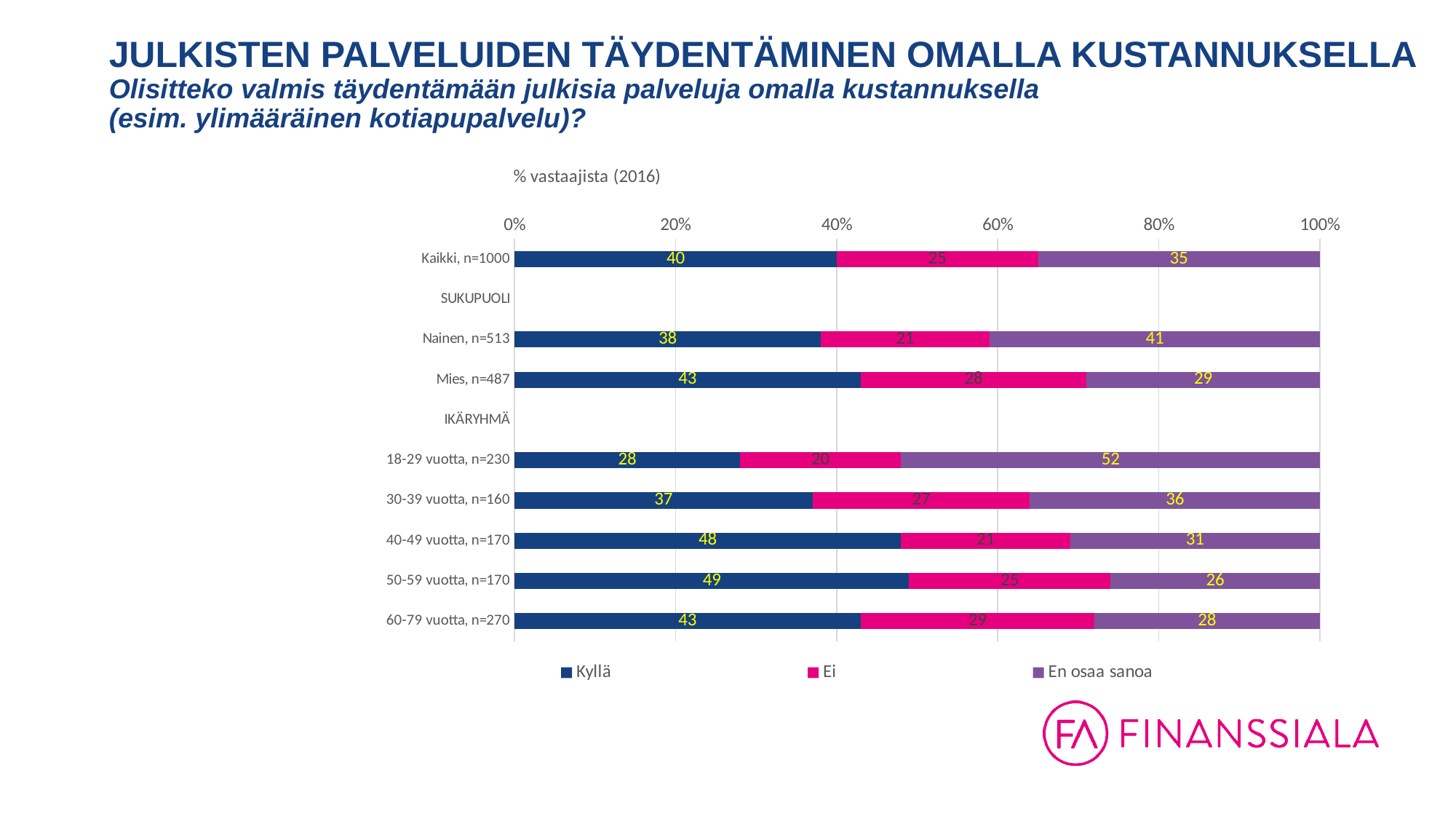
How many series does the legend list? 3 What is the axis title shown above the chart? % vastaajista (2016) Which group has the highest Kyllä value? 50-59 vuotta, n=170 What is the total of the stacked bar for 40-49 vuotta, n=170? 100 What is the difference between the Kyllä values for Mies, n=487 and Nainen, n=513? 5 Which is larger, the En osaa sanoa value for Nainen, n=513 or for Mies, n=487? Nainen, n=513 What kind of chart is shown on the slide? Stacked bar chart Which group has the lowest Kyllä value? 18-29 vuotta, n=230 What is the Kyllä value for Kaikki, n=1000? 40 What is the En osaa sanoa value for 18-29 vuotta, n=230? 52 What is the Ei value for Mies, n=487? 28 How many groups have bars plotted in the chart? 8